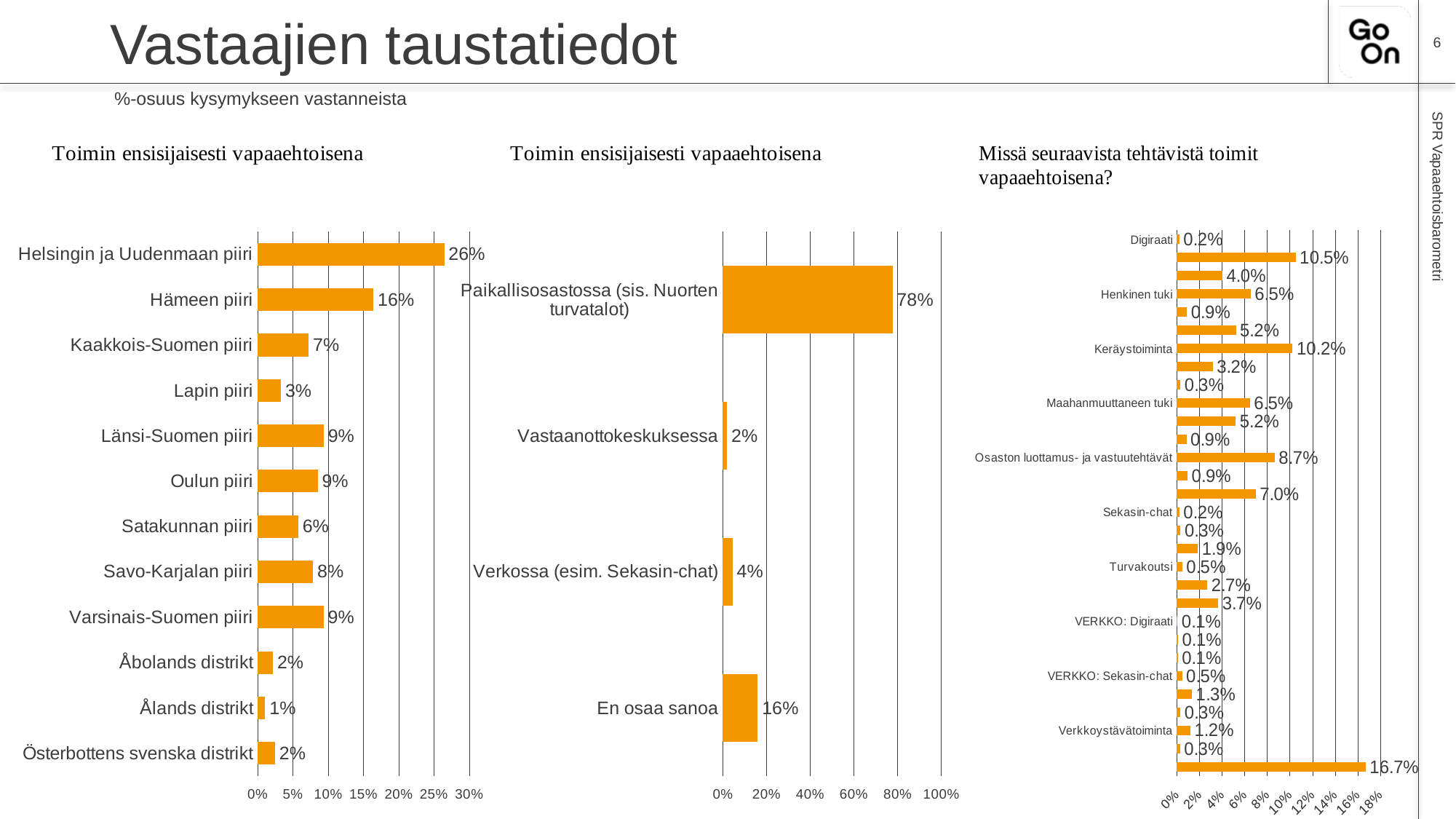
In the left chart, how many districts are listed? 12 In the right chart, what is the value for Keräystoiminta? 10.2% In the middle chart, how many categories are shown? 4 In the left chart, what is the value for Helsingin ja Uudenmaan piiri? 26% In the left chart, which is larger, Satakunnan piiri or Savo-Karjalan piiri? Savo-Karjalan piiri In the left chart, which district has the highest value? Helsingin ja Uudenmaan piiri In the right chart, what is the value for Osaston luottamus- ja vastuutehtävät? 8.7% In the left chart, what is the difference between Helsingin ja Uudenmaan piiri and Hämeen piiri? 10% What type of chart is the middle chart? Bar chart In the left chart, which district has the lowest value? Ålands distrikt In the middle chart, what is the value for En osaa sanoa? 16% In the middle chart, what is the value for Paikallisosastossa (sis. Nuorten turvatalot)? 78%